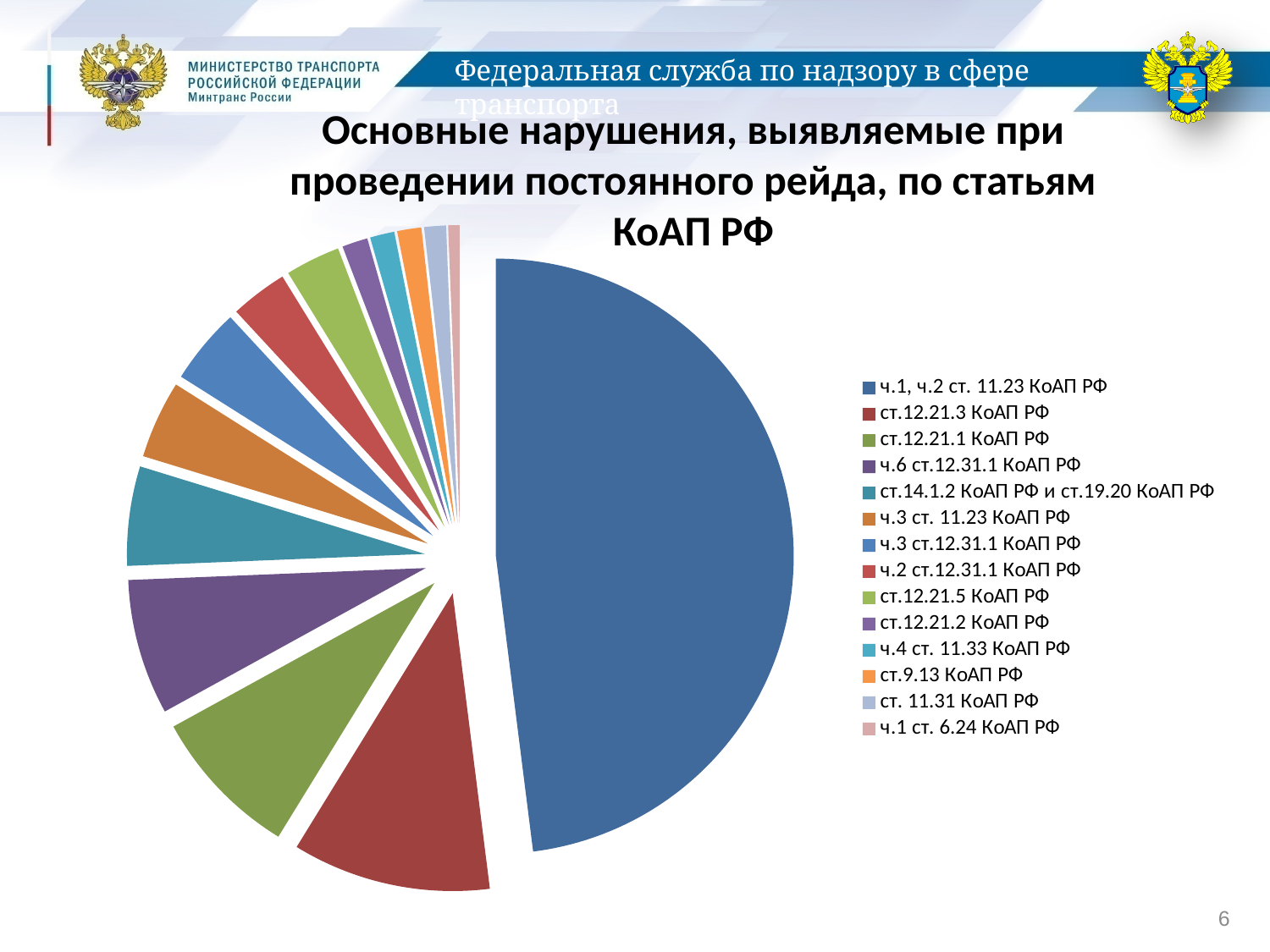
Which slice is larger: ст.12.21.1 КоАП РФ or ст.12.21.5 КоАП РФ? ст.12.21.1 КоАП РФ How many categories (slices) does the pie chart have? 14 What kind of chart is shown on the slide? pie chart What is the title of the chart on the slide? Основные нарушения, выявляемые при проведении постоянного рейда, по статьям КоАП РФ Which slice is larger: ч.6 ст.12.31.1 КоАП РФ or ч.4 ст. 11.33 КоАП РФ? ч.6 ст.12.31.1 КоАП РФ What colour is the slice for ч.1, ч.2 ст. 11.23 КоАП РФ? blue Which category has the largest slice in the pie chart? ч.1, ч.2 ст. 11.23 КоАП РФ Which category has the smallest slice in the pie chart? ч.1 ст. 6.24 КоАП РФ Which slice is larger: ст.14.1.2 КоАП РФ и ст.19.20 КоАП РФ or ст. 11.31 КоАП РФ? ст.14.1.2 КоАП РФ и ст.19.20 КоАП РФ